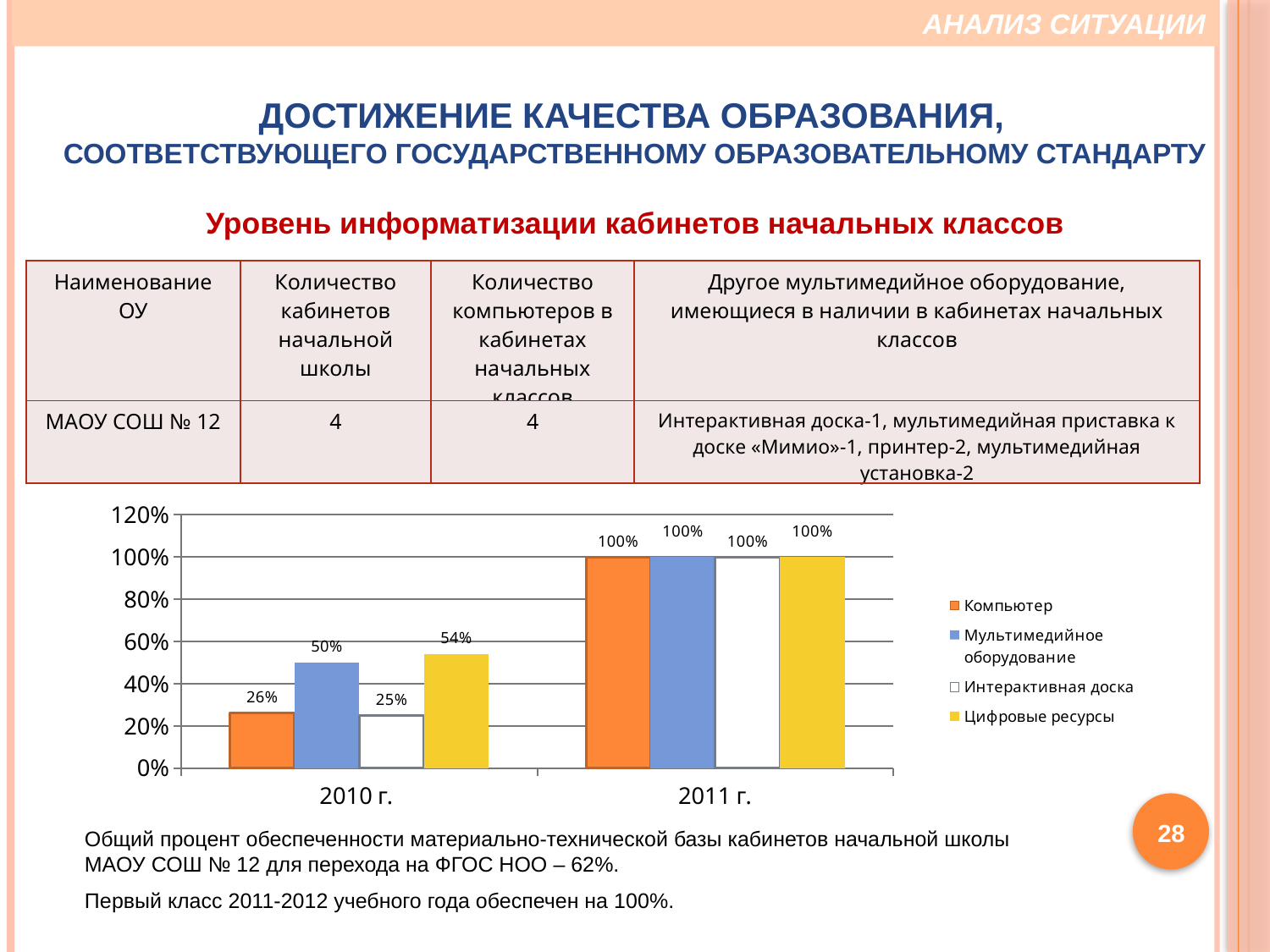
How many series does the chart legend list? 4 What type of chart is shown on the slide? bar chart What is the difference between the Цифровые ресурсы values for 2011 г. and 2010 г.? 46% What is the value for Интерактивная доска in 2010 г.? 25% What is the value for Цифровые ресурсы in 2010 г.? 54% What is the value for Компьютер in 2010 г.? 26% Which series has the highest value in 2010 г.? Цифровые ресурсы What is the value for Мультимедийное оборудование in 2010 г.? 50% Which is larger in 2010 г.: the value for Компьютер or the value for Мультимедийное оборудование? Мультимедийное оборудование How many categories are shown on the x axis of the chart? 2 What is the value for Компьютер in 2011 г.? 100% Do the values for Компьютер rise or fall from 2010 г. to 2011 г.? rise